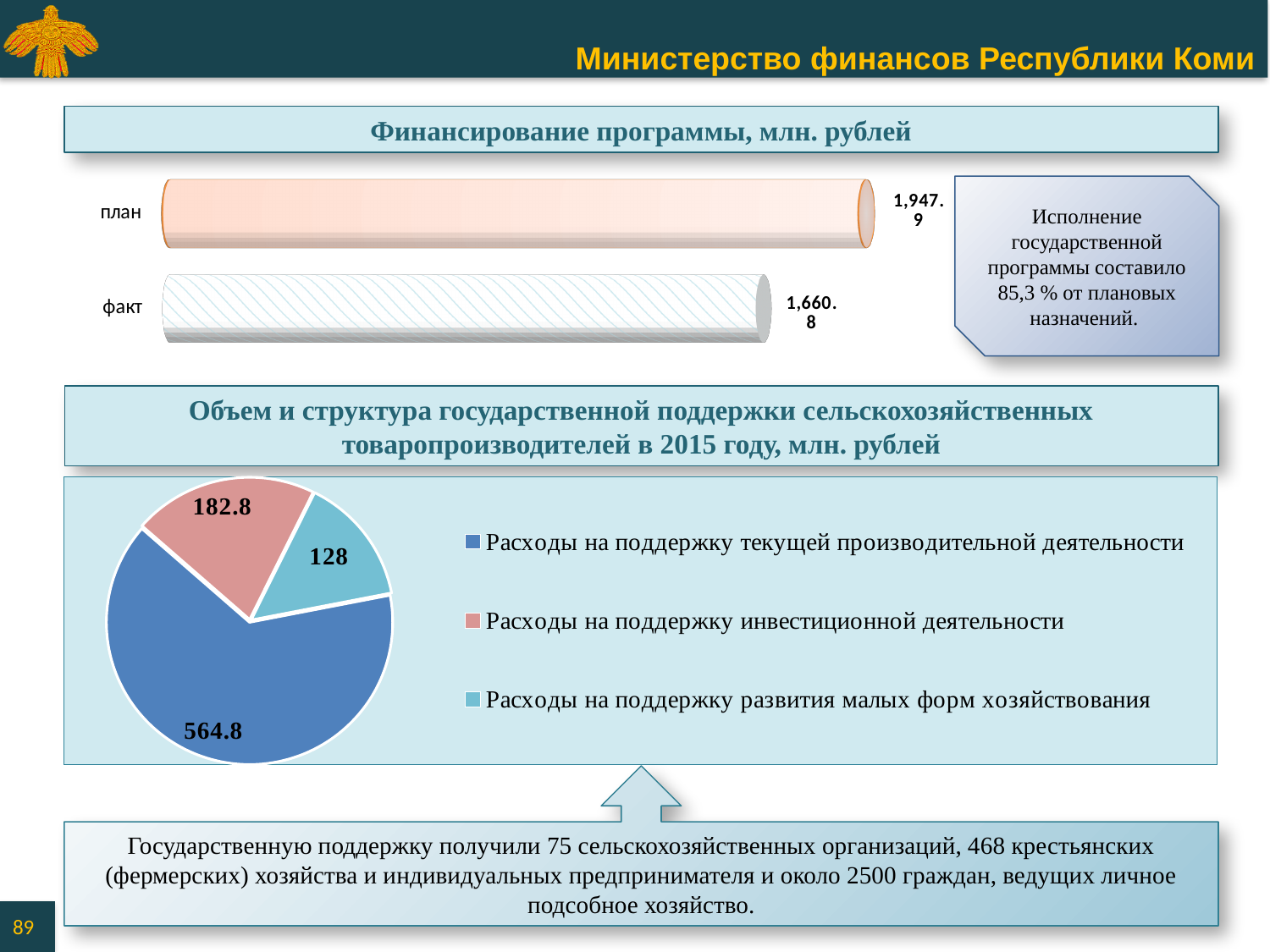
What kind of chart is 'Финансирование программы, млн. рублей'? bar chart In the chart 'Финансирование программы, млн. рублей', what is the value for факт? 1,660.8 In the pie chart 'Объем и структура государственной поддержки сельскохозяйственных товаропроизводителей в 2015 году', what colour is the slice for 'Расходы на поддержку инвестиционной деятельности'? pink In the pie chart 'Объем и структура государственной поддержки сельскохозяйственных товаропроизводителей в 2015 году', what is the difference between 'Расходы на поддержку инвестиционной деятельности' and 'Расходы на поддержку развития малых форм хозяйствования'? 54.8 How many bars are in the chart 'Финансирование программы, млн. рублей'? 2 How many entries does the legend of the pie chart 'Объем и структура государственной поддержки сельскохозяйственных товаропроизводителей в 2015 году' list? 3 In the pie chart 'Объем и структура государственной поддержки сельскохозяйственных товаропроизводителей в 2015 году', what is the value for 'Расходы на поддержку развития малых форм хозяйствования'? 128 In the chart 'Финансирование программы, млн. рублей', what is the difference between план and факт? 287.1 In the pie chart 'Объем и структура государственной поддержки сельскохозяйственных товаропроизводителей в 2015 году', what is the value for 'Расходы на поддержку текущей производительной деятельности'? 564.8 In the chart 'Финансирование программы, млн. рублей', what is the value for план? 1,947.9 In the chart 'Финансирование программы, млн. рублей', which is larger, план or факт? план In the pie chart 'Объем и структура государственной поддержки сельскохозяйственных товаропроизводителей в 2015 году', which category has the smallest value? Расходы на поддержку развития малых форм хозяйствования